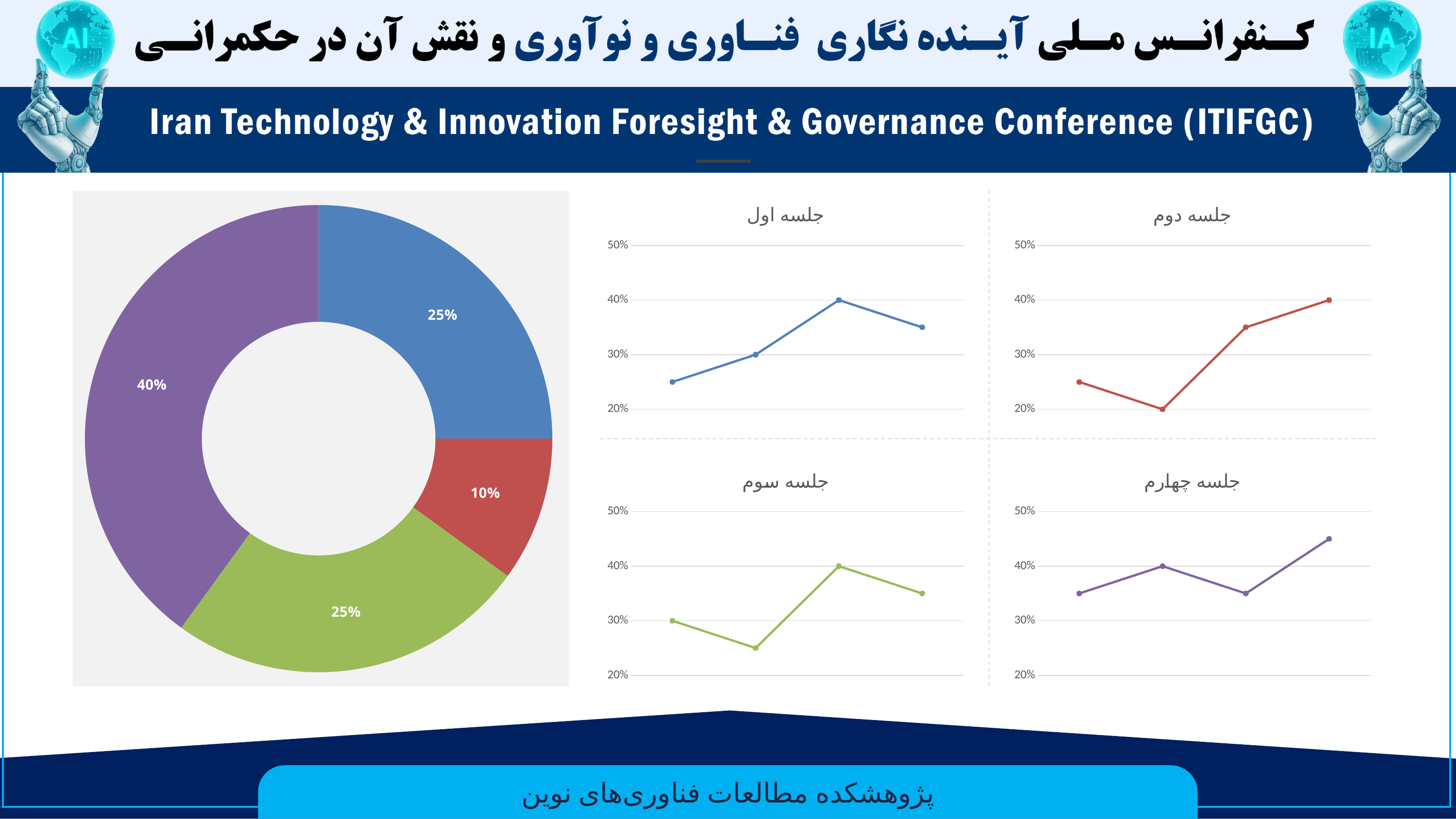
How many slices does the donut chart on the left have? 4 In the donut chart on the left, what is the difference between the purple slice and the red slice? 30% How many data points are plotted in the chart titled جلسه سوم? 4 In the chart titled جلسه چهارم, is the value of the last point greater or less than 40%? greater In the donut chart on the left, what is the value of the largest slice? 40% What type of chart is used for the four small charts on the right side of the slide? Line chart In the donut chart on the left, what is the value of the smallest slice? 10% In the donut chart on the left, which slice is larger, the purple one or the blue one? The purple one (40%) In the donut chart on the left, what is the value of the red slice? 10% What type of chart is shown on the left side of the slide? Donut (pie) chart In the chart titled جلسه اول, what is the value of the third (highest) point? 40% In the chart titled جلسه دوم, what is the value of the second (lowest) point? 20%